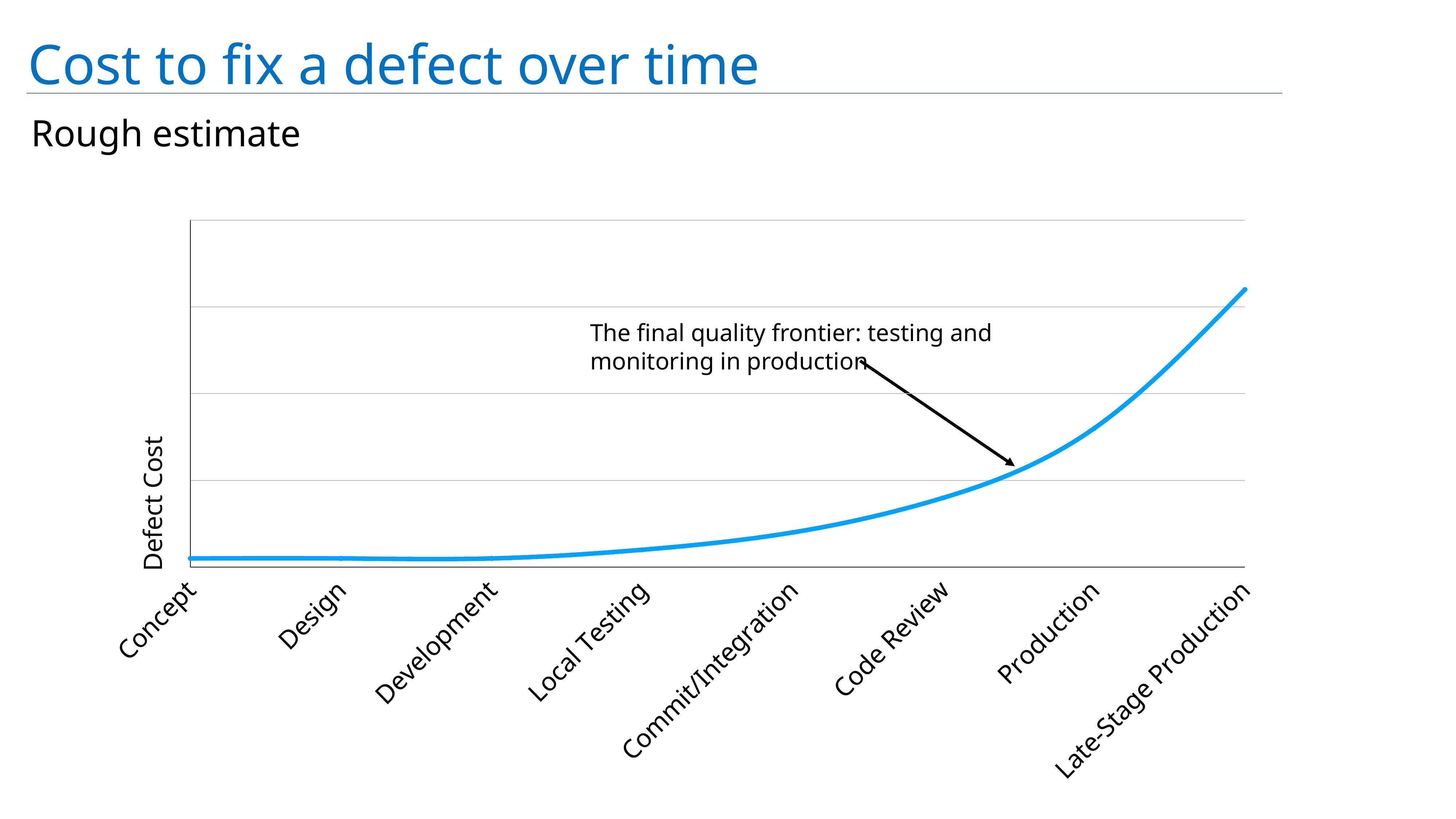
Does the defect cost rise or fall as you move from Concept to Late-Stage Production along the x axis? Rise Is the defect cost higher for Concept or for Late-Stage Production? Late-Stage Production Is the defect cost higher for Production or for Local Testing? Production What is the first category on the x axis of the chart? Concept How many categories are shown along the x axis of the chart? 8 Which category has the highest defect cost in the chart? Late-Stage Production What kind of chart is shown on the slide? Line chart Which category comes immediately after Code Review on the x axis? Production What is the label on the vertical axis of the chart? Defect Cost Is the defect cost higher for Code Review or for Production? Production